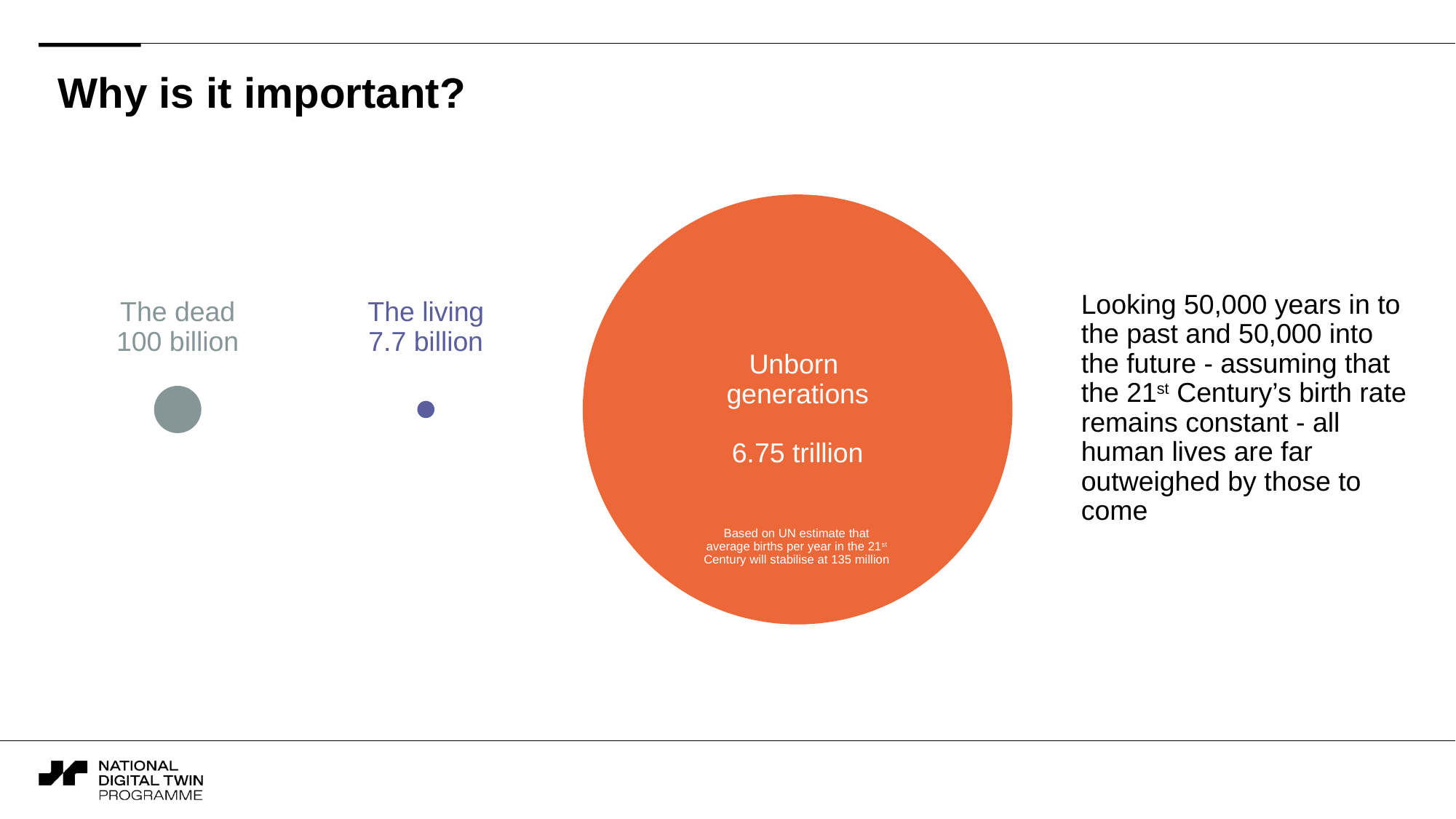
According to the note inside the largest circle, at what level will average births per year in the 21st Century stabilise? 135 million How many categories are shown as circles on the slide? 3 Which category has the smallest value? The living What value is shown for The dead? 100 billion Which is larger, the value for The dead or the value for The living? The dead What kind of chart is used to compare the three groups? Bubble chart What value is shown for The living? 7.7 billion What is the difference between the value for The dead and the value for The living? 92.3 billion What is the title of the slide? Why is it important? Which category has the largest value? Unborn generations What value is shown for Unborn generations? 6.75 trillion What colour is the circle for Unborn generations? Orange